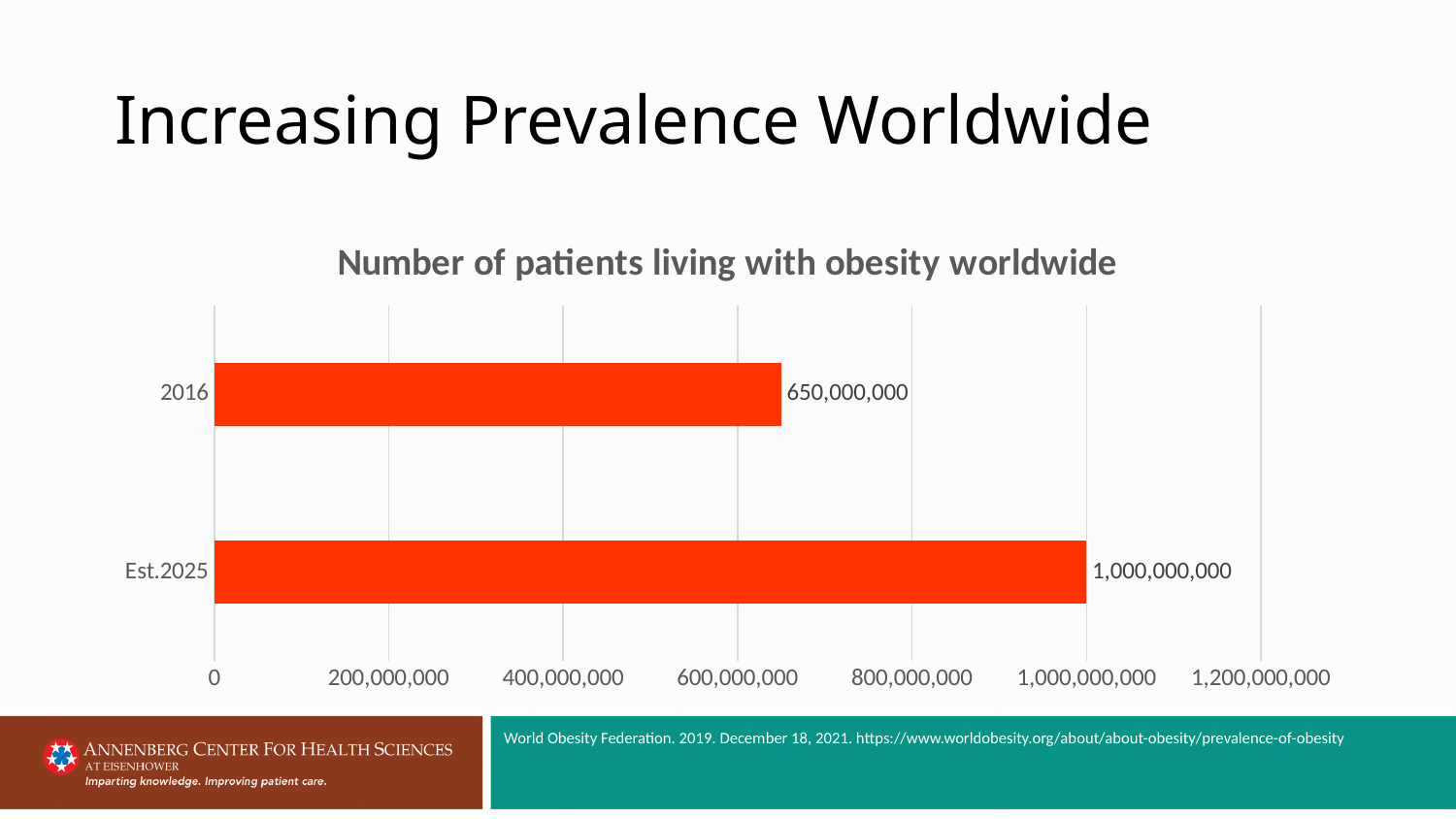
How many categories are shown in the chart? 2 What is the title of the chart? Number of patients living with obesity worldwide What kind of chart is shown on the slide? bar chart Which is larger, the value for 2016 or the value for Est.2025? Est.2025 What colour are the bars in the chart? orange-red What is the difference between the Est.2025 value and the 2016 value? 350,000,000 What is the number of patients living with obesity worldwide in 2016? 650,000,000 Which category has the highest value in the chart? Est.2025 What is the estimated number of patients living with obesity worldwide for Est.2025? 1,000,000,000 Is the value for 2016 greater or less than 800,000,000? less What is the highest value shown on the horizontal axis? 1,200,000,000 Which category has the lowest value in the chart? 2016